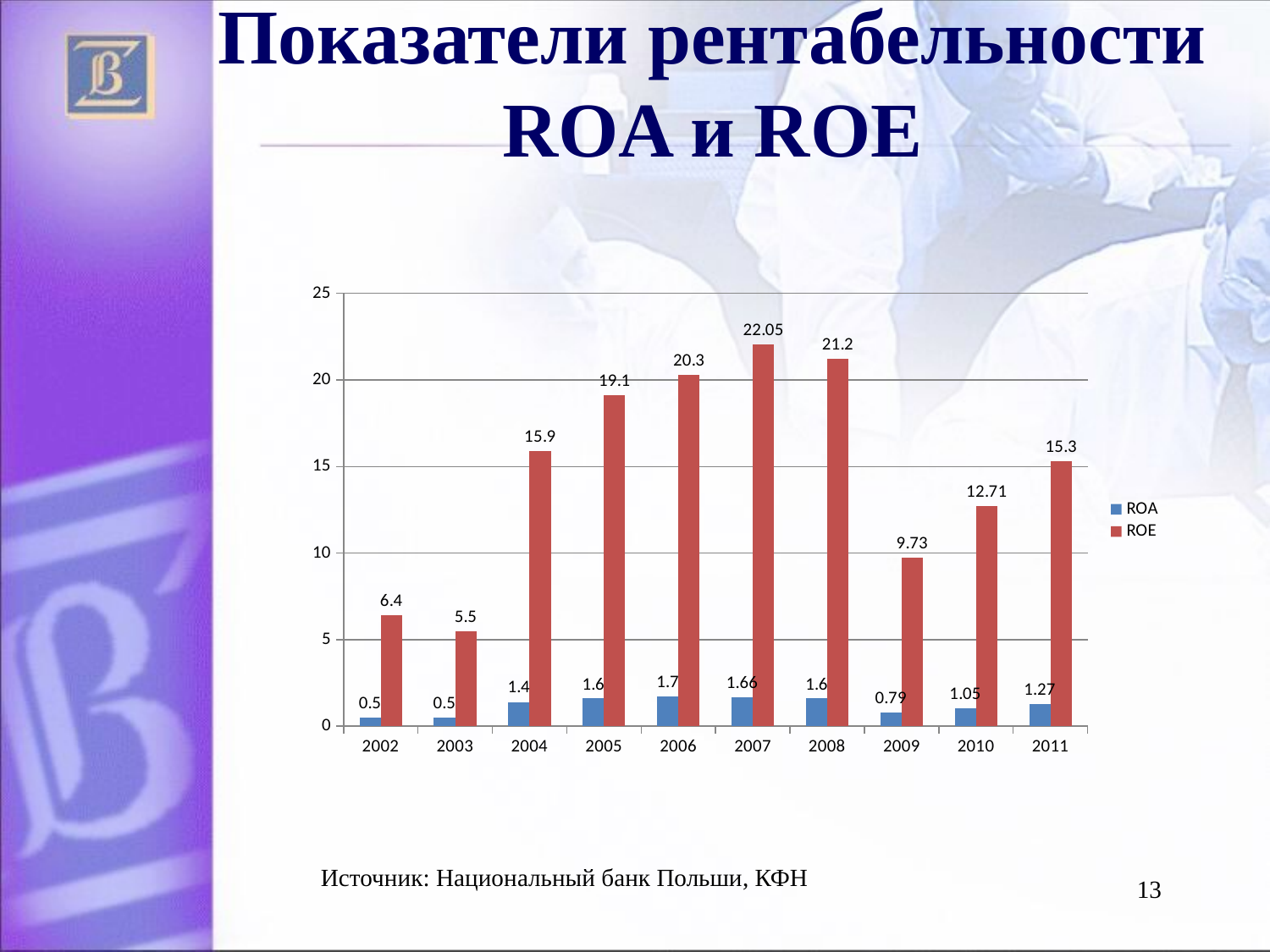
What is the difference between the ROE values for 2008 and 2009? 11.47 Which year has the lowest ROE value? 2003 How many series does the legend list? 2 Which year has the highest ROE value? 2007 What is the ROE value for 2011? 15.3 Is the ROE value for 2010 greater or less than 15? less What kind of chart is shown on the slide? bar chart Which is larger, the ROE value for 2004 or the ROE value for 2011? 2004 What is the ROA value for 2009? 0.79 How many years are shown on the x axis? 10 What is the ROE value for 2007? 22.05 Which year has the highest ROA value? 2006